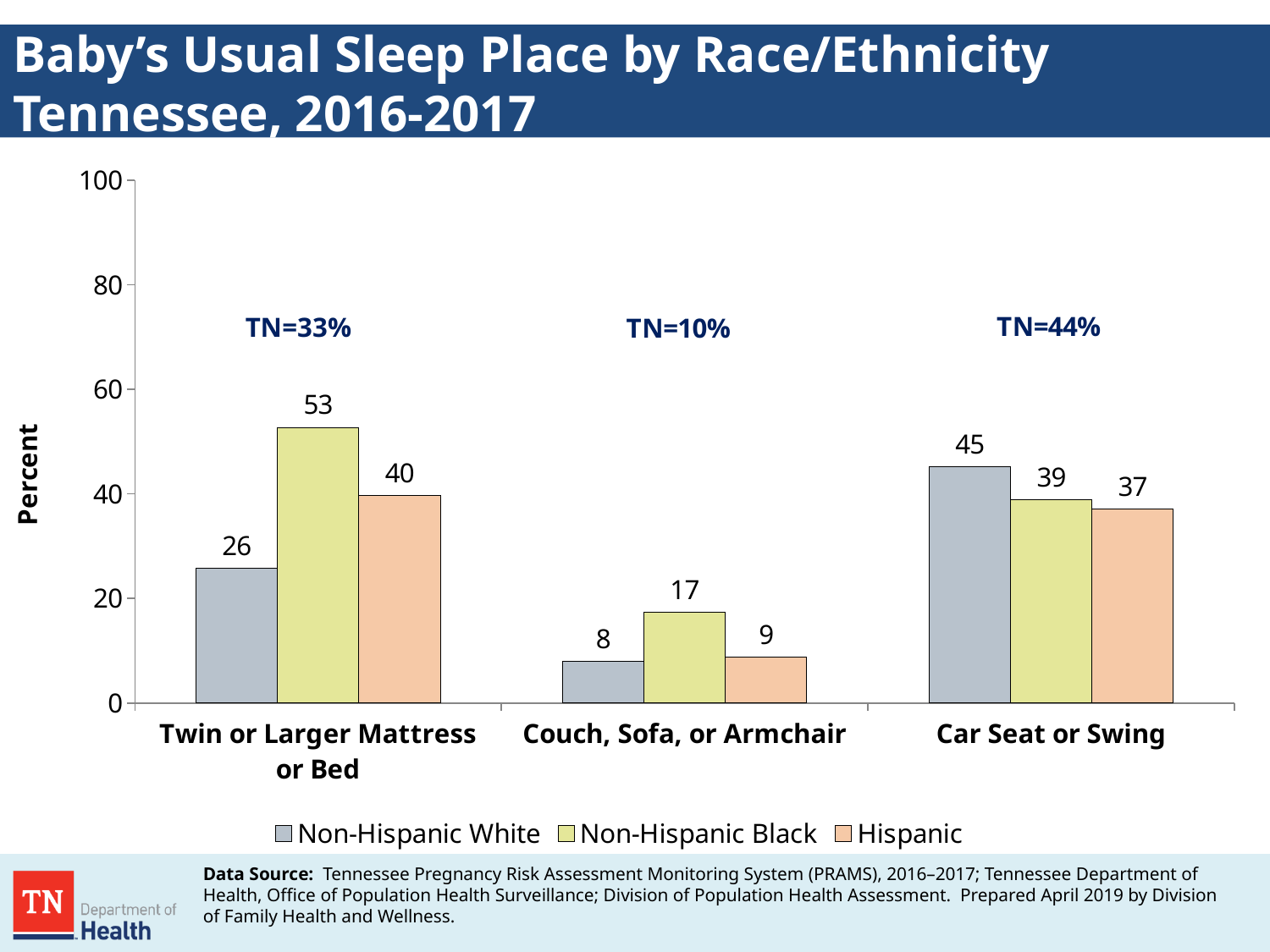
What is the Tennessee overall percentage (TN=) shown above the Car Seat or Swing group? TN=44% How many sleep place categories are shown on the x axis? 3 Is the Non-Hispanic White value for Car Seat or Swing greater or less than 40? greater What kind of chart is shown on the slide? Bar chart Which race/ethnicity group has the lowest value for Twin or Larger Mattress or Bed? Non-Hispanic White Which race/ethnicity group has the highest value for Car Seat or Swing? Non-Hispanic White Which is larger for Couch, Sofa, or Armchair: the Non-Hispanic Black value or the Hispanic value? Non-Hispanic Black What is the value for Non-Hispanic White for Couch, Sofa, or Armchair? 8 What is the difference between the Non-Hispanic Black and Non-Hispanic White values for Twin or Larger Mattress or Bed? 27 What is the value for Non-Hispanic Black for Twin or Larger Mattress or Bed? 53 What is the value for Hispanic for Car Seat or Swing? 37 How many series does the legend list? 3